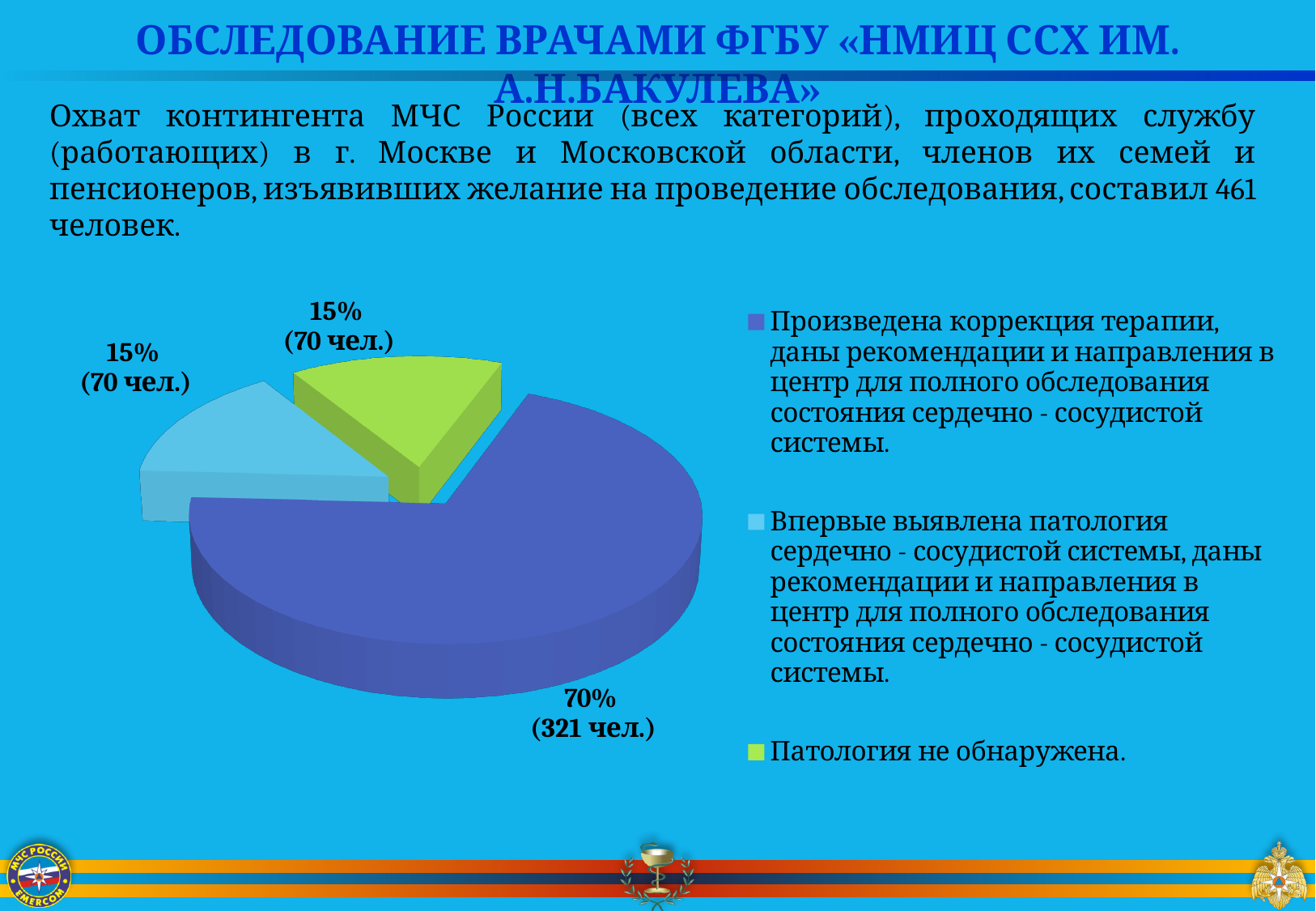
What percentage share does the largest slice of the pie chart have? 70% What colour is the slice labelled «Патология не обнаружена» in the pie chart? green What is the difference in number of people between the 70% slice and one of the 15% slices? 251 How many slices does the pie chart have? 3 How many people are in the slice «Патология не обнаружена»? 70 чел. What is the total number of people across all three slices of the pie chart? 461 Which legend category corresponds to the largest slice of the pie chart? Произведена коррекция терапии, даны рекомендации и направления в центр для полного обследования состояния сердечно - сосудистой системы. How many people does the largest slice of the pie chart represent? 321 чел. How many entries does the legend of the pie chart list? 3 Which is larger: the slice «Впервые выявлена патология сердечно - сосудистой системы...» or the slice «Произведена коррекция терапии...»? Произведена коррекция терапии... What percentage share does the slice labelled «Патология не обнаружена» have? 15% What kind of chart is shown on the slide? pie chart